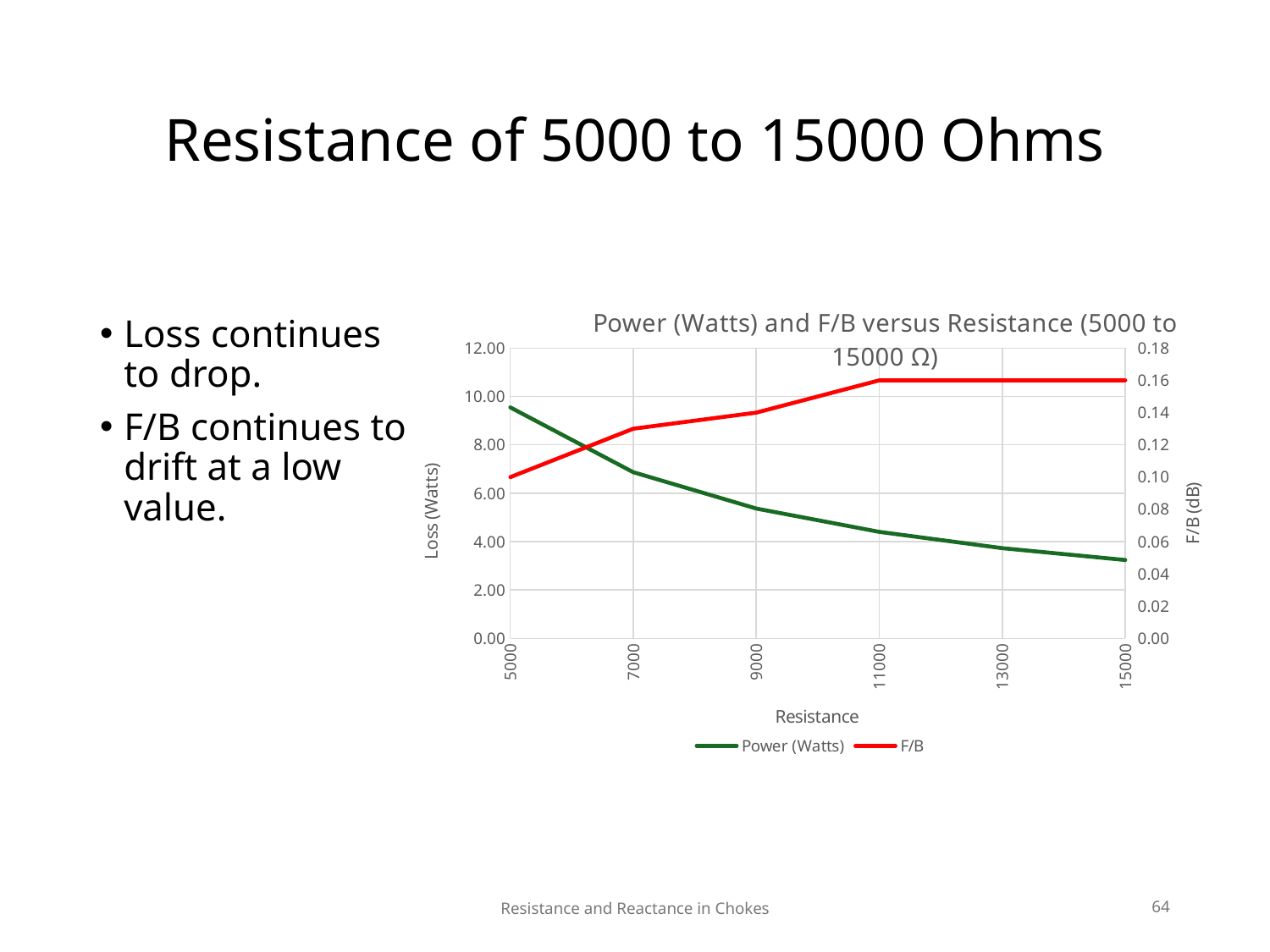
How many resistance values are marked along the x axis of the chart? 6 Is the F/B value at a resistance of 5000 greater or less than 0.12? less How many series does the chart legend list? 2 At which resistance is the Power (Watts) value highest? 5000 What is the label of the right-hand vertical axis of the chart? F/B (dB) Does the Power (Watts) series rise or fall as resistance increases from 5000 to 15000? fall Is the Power (Watts) value at a resistance of 5000 greater or less than 8.00? greater Does the F/B series rise or fall as resistance increases from 5000 to 11000? rise Which is larger, the Power (Watts) value at 7000 or at 13000? 7000 Is the Power (Watts) value at a resistance of 15000 greater or less than 4.00? less At which resistance is the Power (Watts) value lowest? 15000 What kind of chart is shown on the slide? line chart